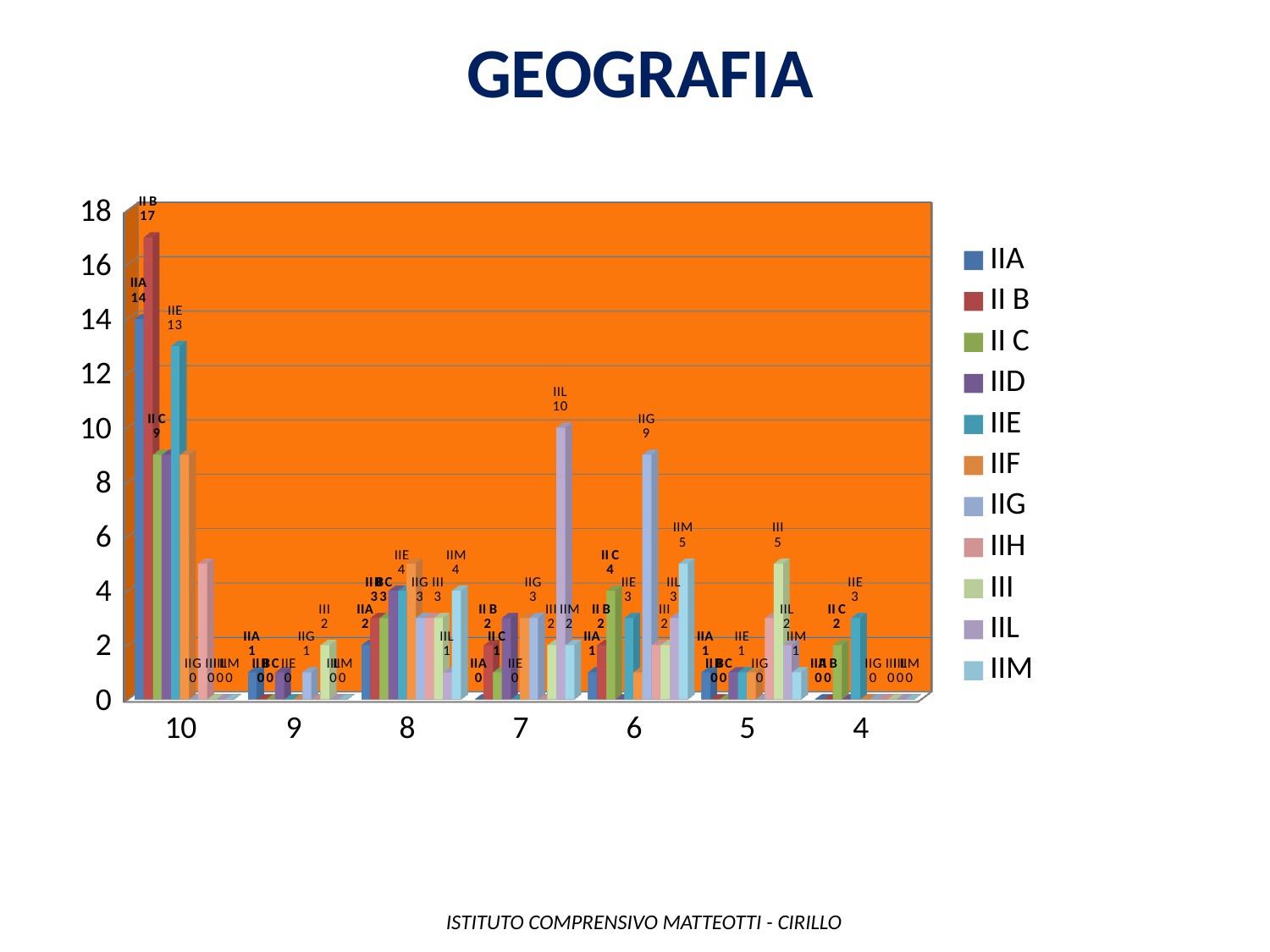
What is the difference between the II B value and the IIA value at category 10? 3 What is the value for IIL at category 7? 10 What is the title of the chart? GEOGRAFIA What kind of chart is shown on the slide? bar chart What is the value for II B at category 10? 17 What is the value for IIG at category 6? 9 What is the value for IIE at category 10? 13 What is the value for III at category 5? 5 Which is larger at category 6, the value for IIG or the value for IIM? IIG How many series does the legend list? 11 Which series has the highest value at category 10? II B How many categories are shown on the x axis? 7